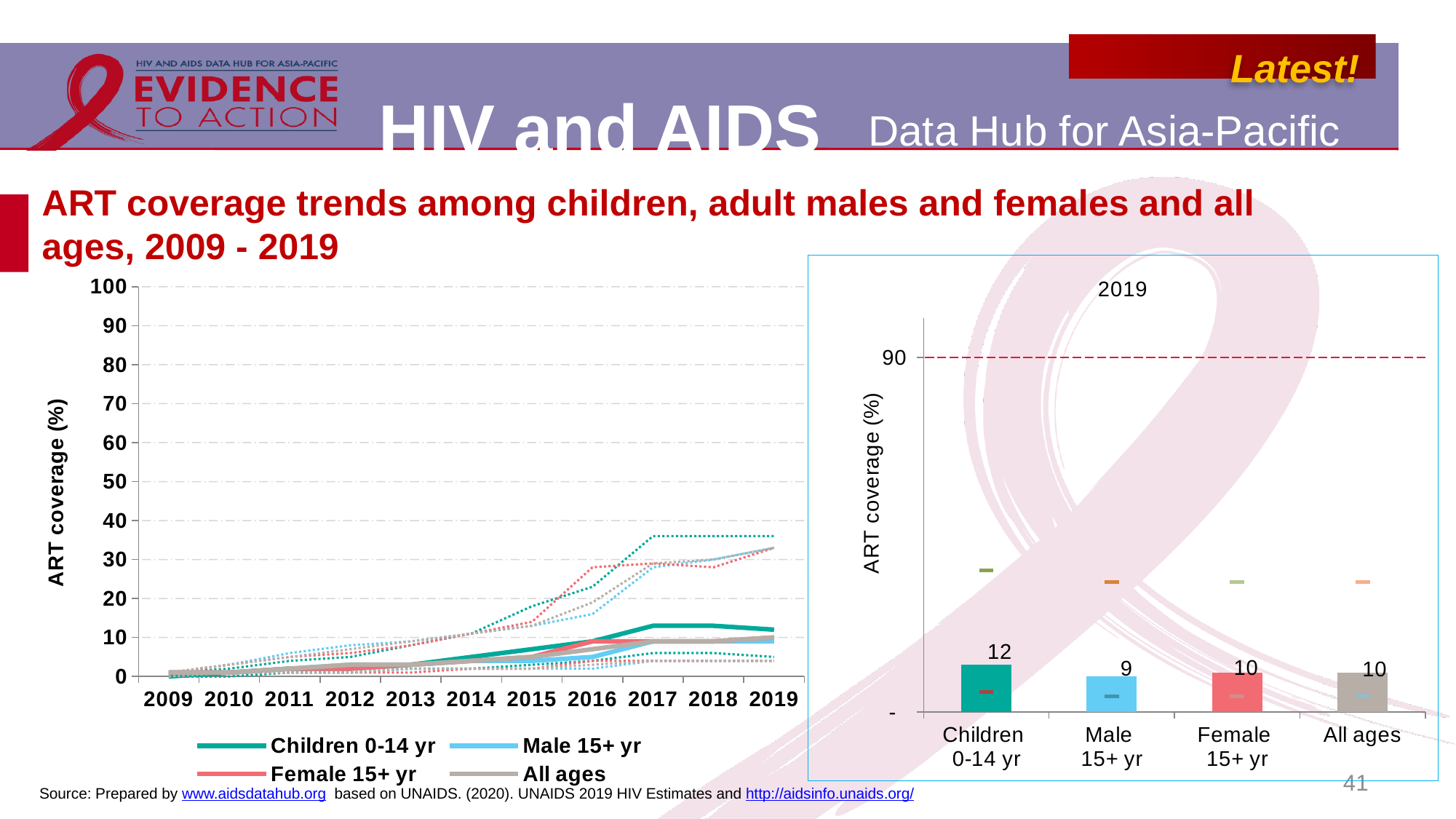
In the 2019 bar chart on the right, what is the ART coverage value for Female 15+ yr? 10 How many series does the legend of the left line chart list? 4 In the 2019 bar chart on the right, which category has the highest ART coverage? Children 0-14 yr In the 2019 bar chart on the right, what is the difference between the values for Children 0-14 yr and Male 15+ yr? 3 In the left line chart, does the solid Children 0-14 yr line generally rise or fall from 2009 to 2019? rise In the left line chart, is the solid Children 0-14 yr line in 2019 greater or less than 20? less In the 2019 bar chart on the right, what is the ART coverage value for Children 0-14 yr? 12 In the 2019 bar chart on the right, what is the ART coverage value for Male 15+ yr? 9 What kind of chart is the left chart showing ART coverage trends from 2009 to 2019? line chart In the 2019 bar chart on the right, what value does the red dashed horizontal line mark? 90 In the 2019 bar chart on the right, how many categories are shown on the x axis? 4 In the 2019 bar chart on the right, which category has the lowest ART coverage? Male 15+ yr